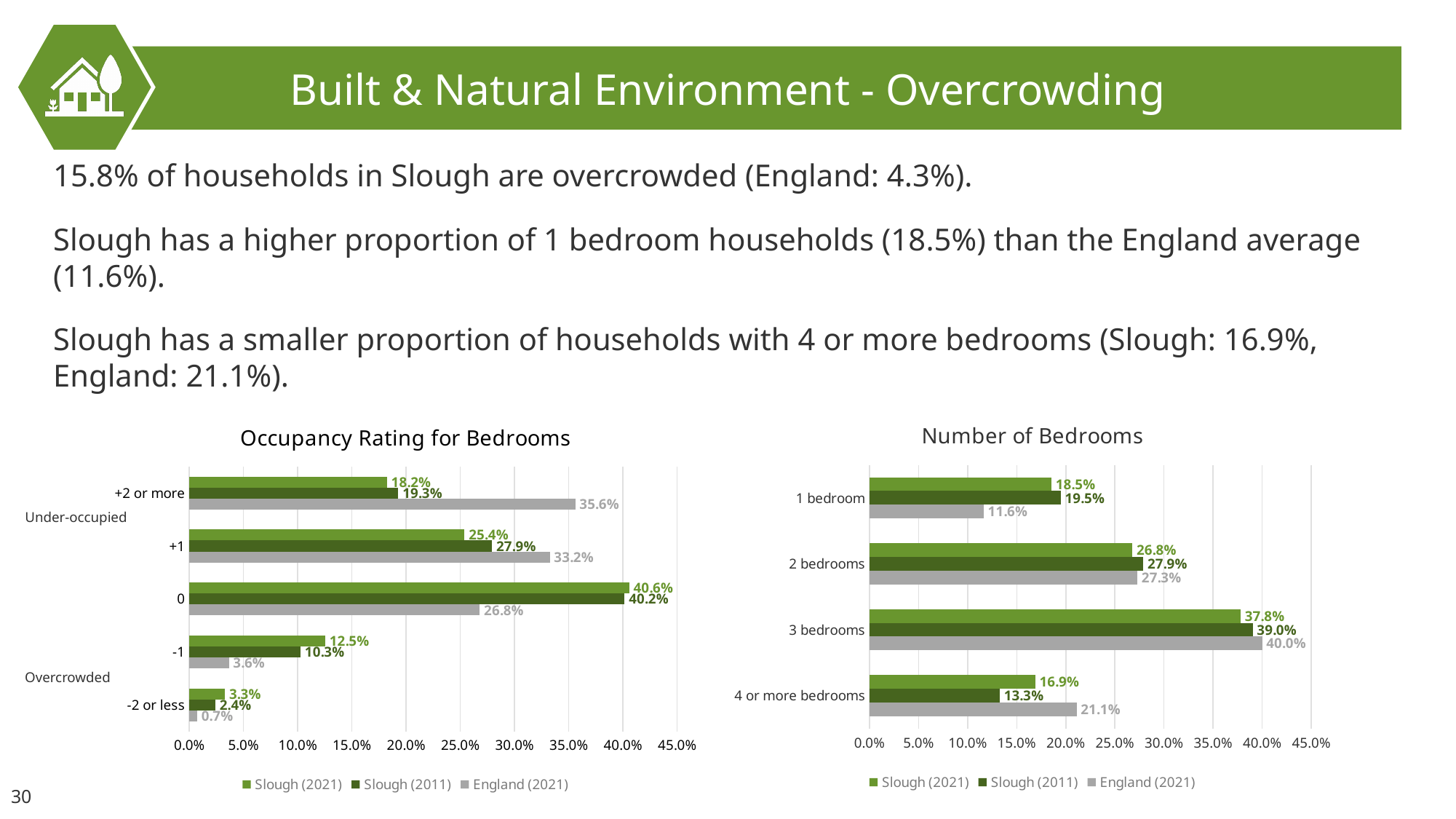
What type of chart is the 'Number of Bedrooms' chart? Bar chart In the 'Occupancy Rating for Bedrooms' chart, what is the Slough (2021) value for the 0 occupancy rating? 40.6% In the 'Occupancy Rating for Bedrooms' chart, what is the England (2021) value for +2 or more? 35.6% In the 'Occupancy Rating for Bedrooms' chart, which colour represents England (2021)? Grey In the 'Number of Bedrooms' chart, which is larger for 1 bedroom: Slough (2021) or England (2021)? Slough (2021) In the 'Occupancy Rating for Bedrooms' chart, how many series does the legend list? 3 In the 'Number of Bedrooms' chart, what is the Slough (2011) value for 4 or more bedrooms? 13.3% In the 'Occupancy Rating for Bedrooms' chart, what is the difference between the Slough (2021) and England (2021) values for -1? 8.9% In the 'Occupancy Rating for Bedrooms' chart, which category has the lowest England (2021) value? -2 or less In the 'Number of Bedrooms' chart, what is the difference between the England (2021) and Slough (2021) values for 4 or more bedrooms? 4.2% In the 'Number of Bedrooms' chart, which category has the highest Slough (2021) value? 3 bedrooms In the 'Number of Bedrooms' chart, how many bedroom categories are shown? 4